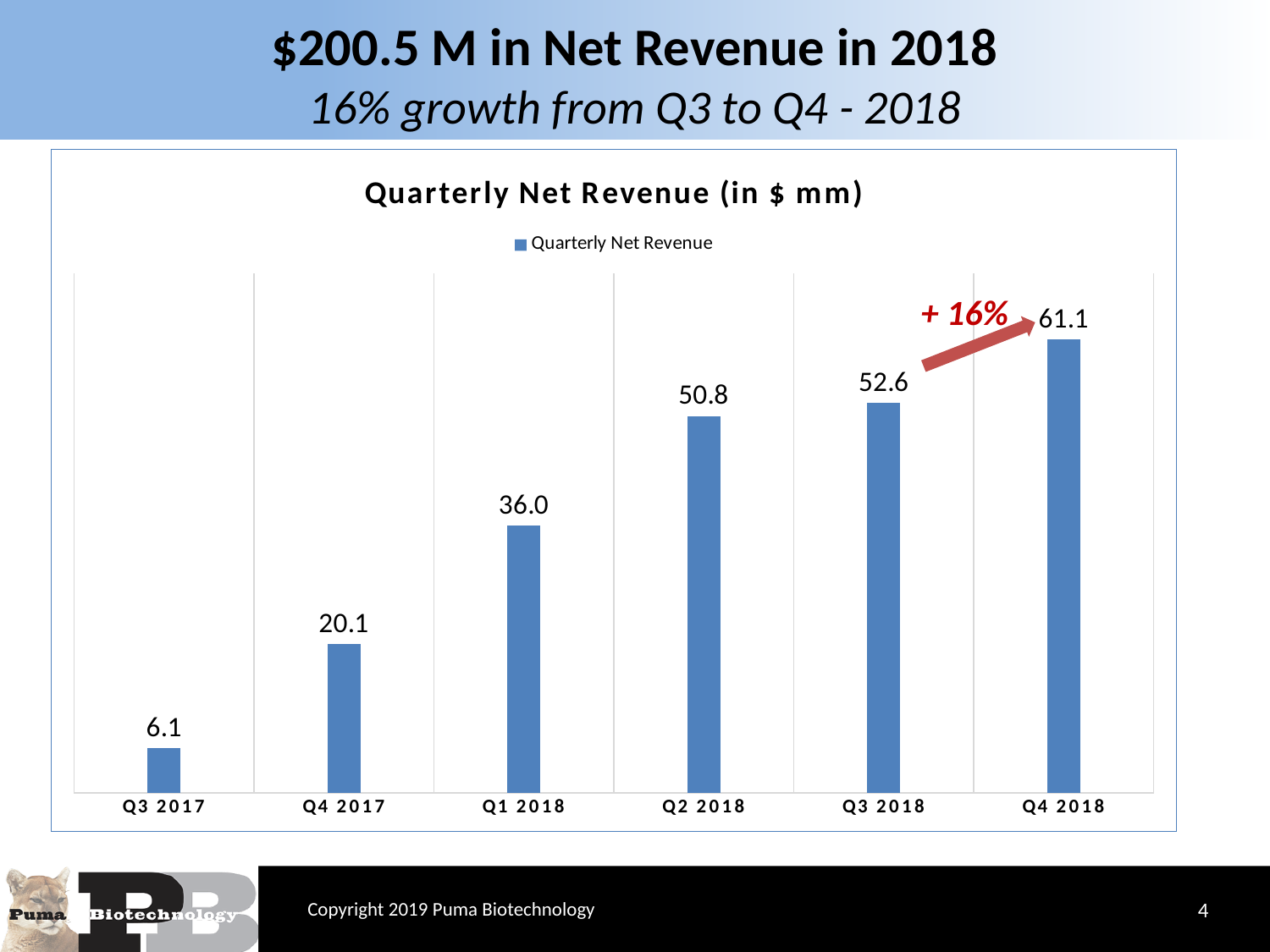
What is the difference in net revenue between Q4 2018 and Q3 2018? 8.5 Which is larger, the net revenue for Q4 2017 or for Q1 2018? Q1 2018 How many quarters are shown on the chart? 6 Which quarter has the lowest net revenue? Q3 2017 What kind of chart is shown on the slide? Bar chart What is the quarterly net revenue for Q3 2017? 6.1 What is the difference in net revenue between Q2 2018 and Q1 2018? 14.8 Which quarter has the highest net revenue? Q4 2018 What is the quarterly net revenue for Q4 2018? 61.1 Do the net revenue values rise or fall from Q3 2017 to Q4 2018? Rise How many series does the legend list? 1 What is the quarterly net revenue for Q1 2018? 36.0